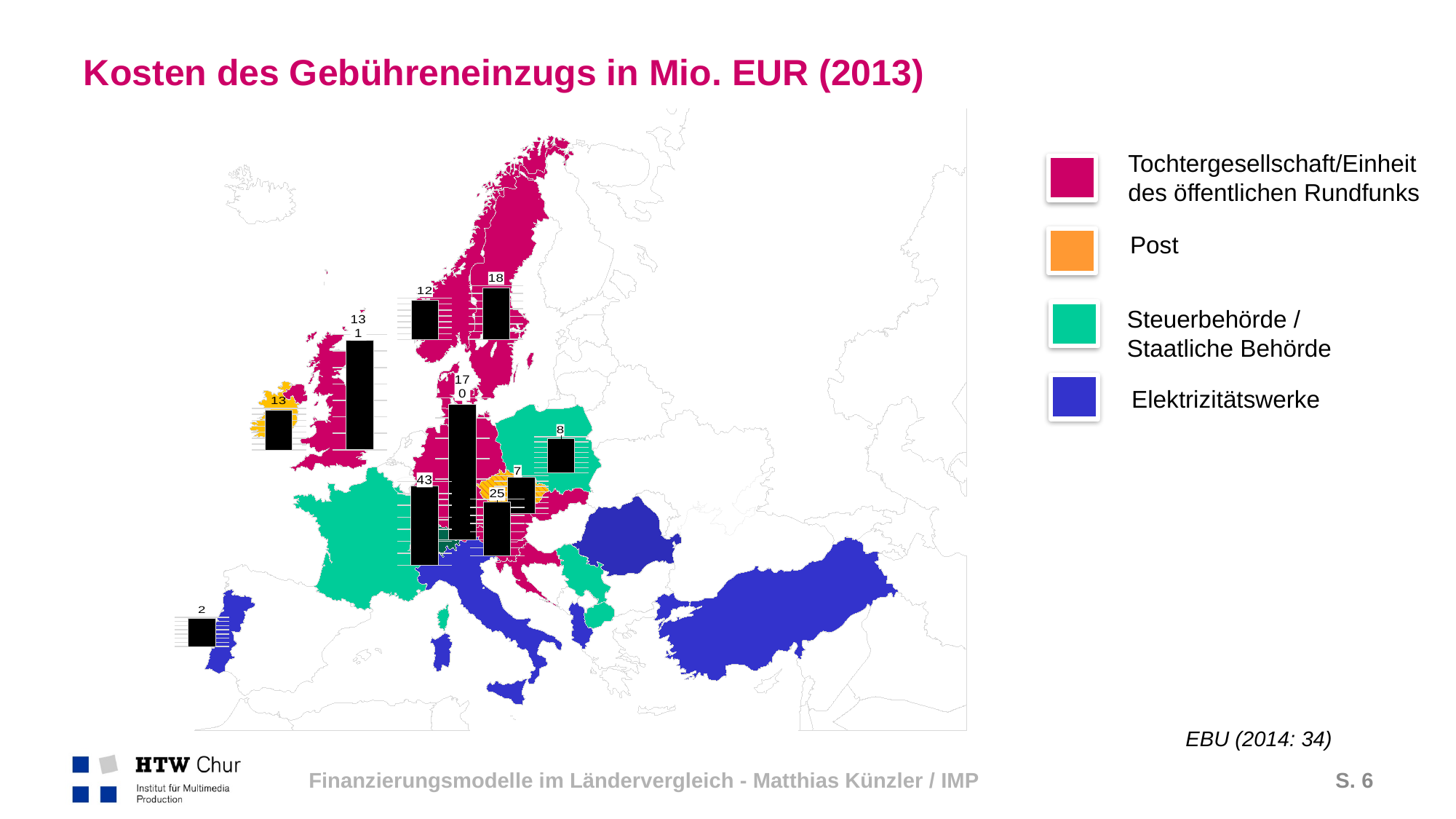
What value is shown for Poland on the map? 8 What is the title of the chart on the slide? Kosten des Gebühreneinzugs in Mio. EUR (2013) What value is shown for Sweden on the map? 18 Which has the larger value, Sweden or Norway? Sweden Which country has the lowest value shown on the map? Portugal Which legend category is shown in orange? Post What value is shown for Norway on the map? 12 What value is shown for France on the map? 43 What is the difference between the values for France and Austria? 18 What value is shown for Portugal on the map? 2 How many categories does the legend of the map chart list? 4 What value is shown for Austria on the map? 25